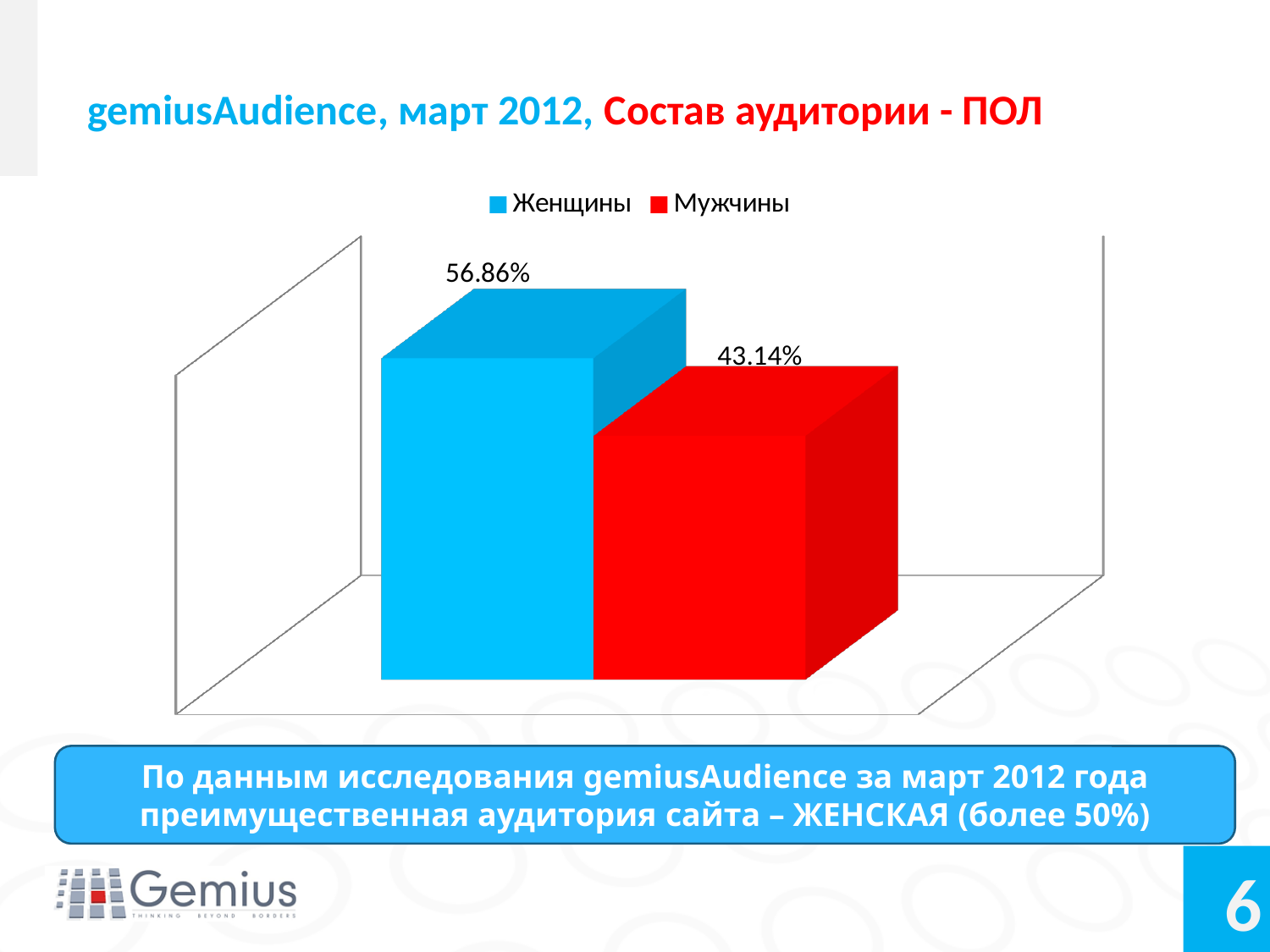
What colour is the bar for Женщины? blue What kind of chart is shown on the slide? bar chart Which is larger, the value for Женщины or the value for Мужчины? Женщины What is the difference between the values for Женщины and Мужчины? 13.72% How many bars are plotted on the chart? 2 What is the total of the two plotted values? 100% What is the value for Мужчины? 43.14% What colour is the bar for Мужчины? red How many series does the legend list? 2 What is the value for Женщины? 56.86% Which series has the lowest value? Мужчины Which series has the highest value? Женщины